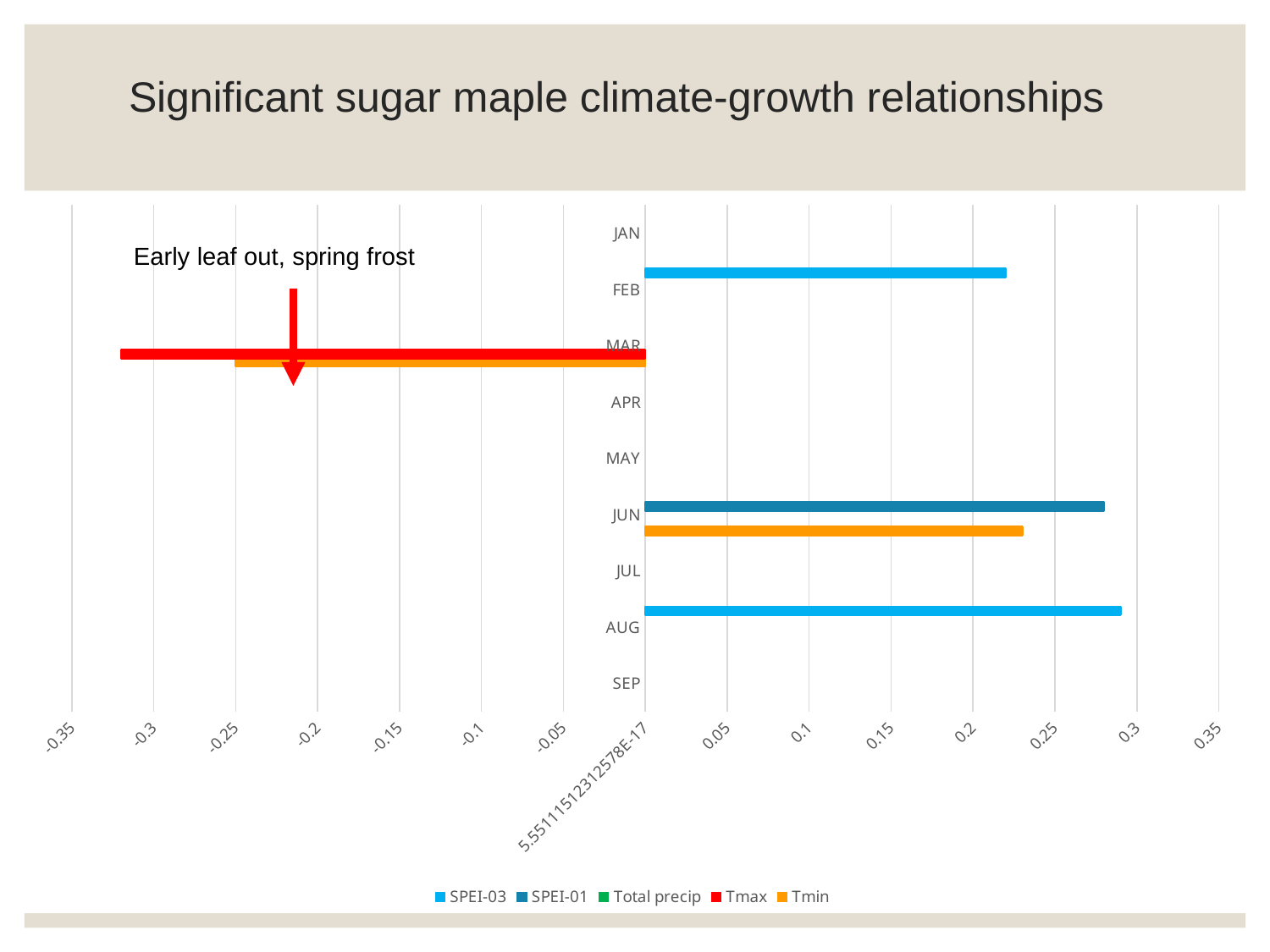
How many months are listed as categories on the vertical axis of the chart? 9 In JUN, which series has the larger value, SPEI-01 or Tmin? SPEI-01 Is the SPEI-03 value for FEB greater or less than 0.15? greater What text annotation appears above the red arrow on the chart? Early leaf out, spring frost Is the Tmin value for JUN greater or less than 0.15? greater Which month has the most negative bar in the chart? MAR Which is larger, the SPEI-03 value for AUG or the SPEI-03 value for FEB? AUG Is the SPEI-01 value for JUN greater or less than 0.25? greater How many series does the chart legend list? 5 What kind of chart is shown on the slide? bar chart